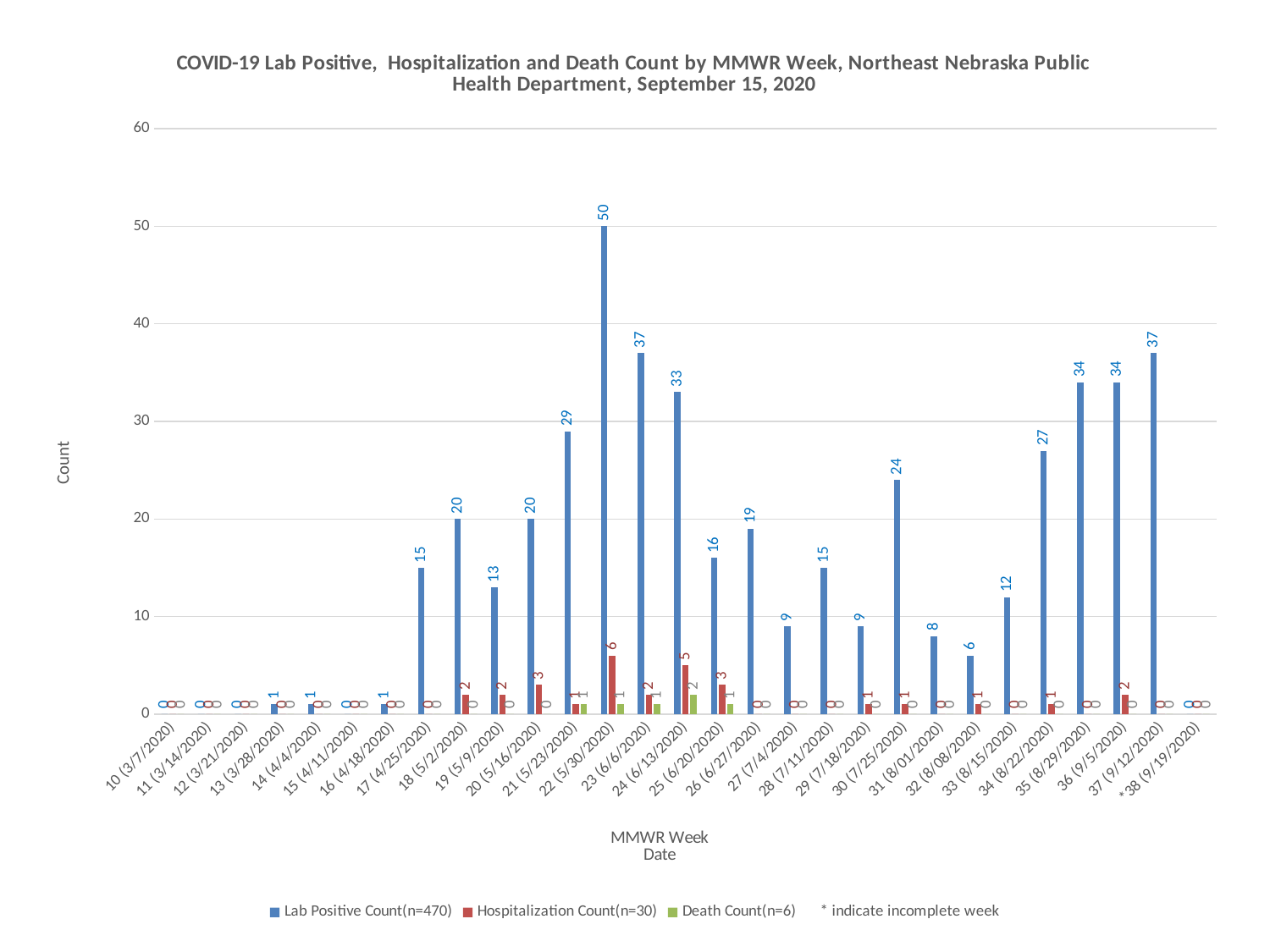
How many series does the legend list? 3 Which MMWR week has the highest Hospitalization Count? 22 (5/30/2020) What kind of chart is shown on the slide? Bar chart Which MMWR week has the highest Lab Positive Count? 22 (5/30/2020) What is the Hospitalization Count for MMWR week 24 (6/13/2020)? 5 Is the Lab Positive Count for week 21 (5/23/2020) greater or less than 20? greater How many MMWR weeks are shown on the x axis? 29 What is the total n shown in the legend for the Hospitalization Count series? 30 What is the Lab Positive Count for MMWR week 22 (5/30/2020)? 50 What is the difference between the Lab Positive Count for week 22 (5/30/2020) and week 23 (6/6/2020)? 13 Which is larger, the Lab Positive Count for week 30 (7/25/2020) or for week 34 (8/22/2020)? 34 (8/22/2020) What is the Death Count for MMWR week 24 (6/13/2020)? 2